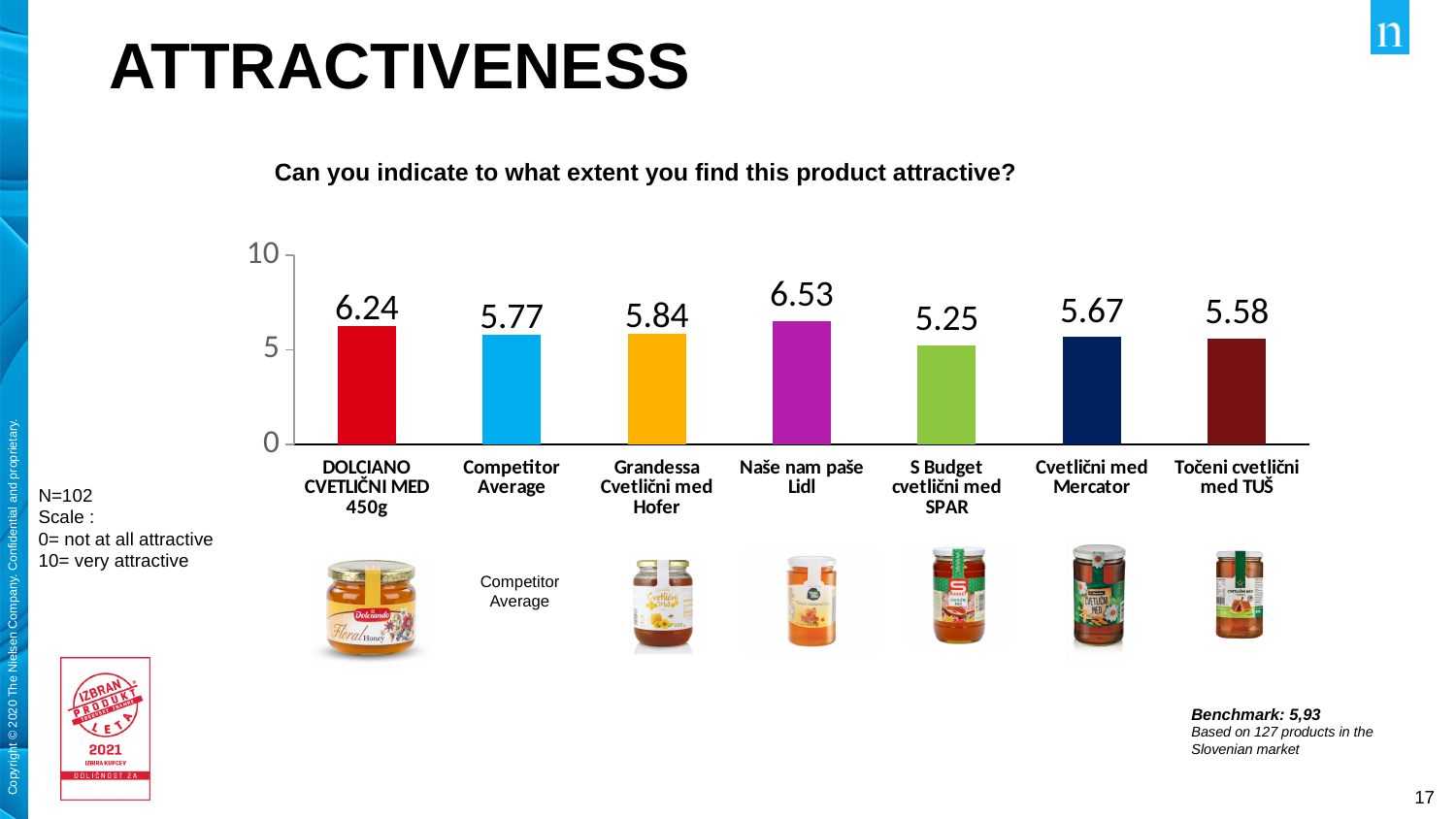
What is the difference between the DOLCIANO CVETLIČNI MED 450g score and the Competitor Average? 0.47 What type of chart is shown on the slide? Bar chart Which has a higher score, Grandessa Cvetlični med Hofer or Cvetlični med Mercator? Grandessa Cvetlični med Hofer What is the maximum value shown on the vertical axis of the chart? 10 How many bars are shown in the chart? 7 What is the difference between the scores for Naše nam paše Lidl and DOLCIANO CVETLIČNI MED 450g? 0.29 What is the attractiveness score for DOLCIANO CVETLIČNI MED 450g? 6.24 Which product has the lowest attractiveness score? S Budget cvetlični med SPAR Which product has the highest attractiveness score? Naše nam paše Lidl What is the value shown for Competitor Average? 5.77 What is the attractiveness score for S Budget cvetlični med SPAR? 5.25 What is the attractiveness score for Naše nam paše Lidl? 6.53